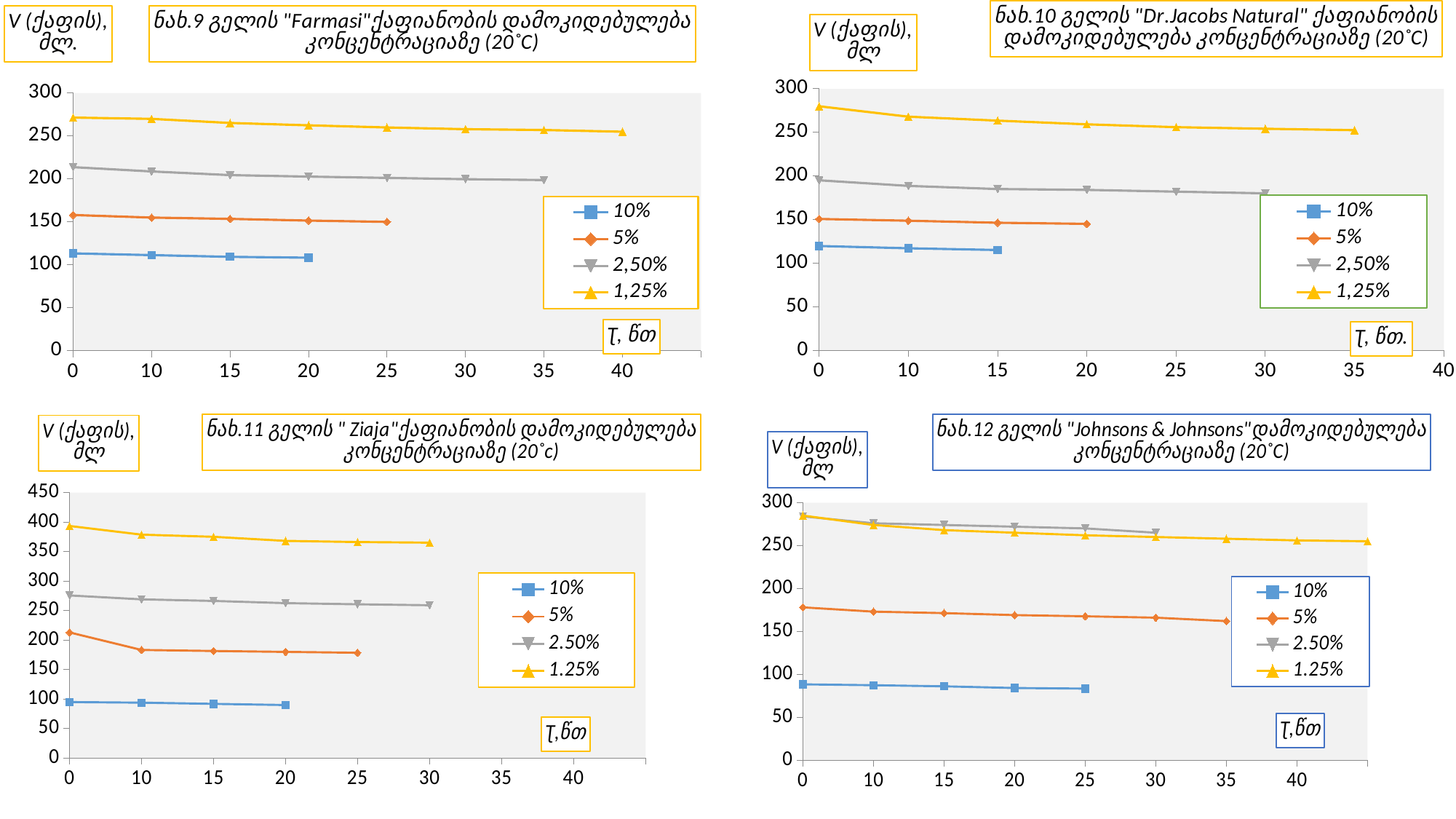
Which gel brand is named in the title of the bottom-right chart (ნახ.12)? Johnsons & Johnsons In the top-left chart ("Farmasi"), is the value of the 1,25% series at τ = 0 greater or less than 250? greater In the top-left chart ("Farmasi"), how many data points does the 1,25% series have? 8 In the top-right chart ("Dr.Jacobs Natural"), how many data points does the 10% series have? 3 In the bottom-right chart ("Johnsons & Johnsons"), is the value of the 10% series at τ = 0 greater or less than 100? less In the bottom-left chart ("Ziaja"), is the value of the 1.25% series at τ = 0 greater or less than 350? greater In the bottom-left chart ("Ziaja"), which series has the highest values? 1.25% In the bottom-left chart ("Ziaja"), do the values of the 5% series rise or fall as τ increases? fall In the bottom-right chart ("Johnsons & Johnsons"), which series has the lowest values? 10% How many series does the legend of the top-right chart (ნახ.10, "Dr.Jacobs Natural") list? 4 What kind of chart is the top-left chart (ნახ.9, "Farmasi")? line chart